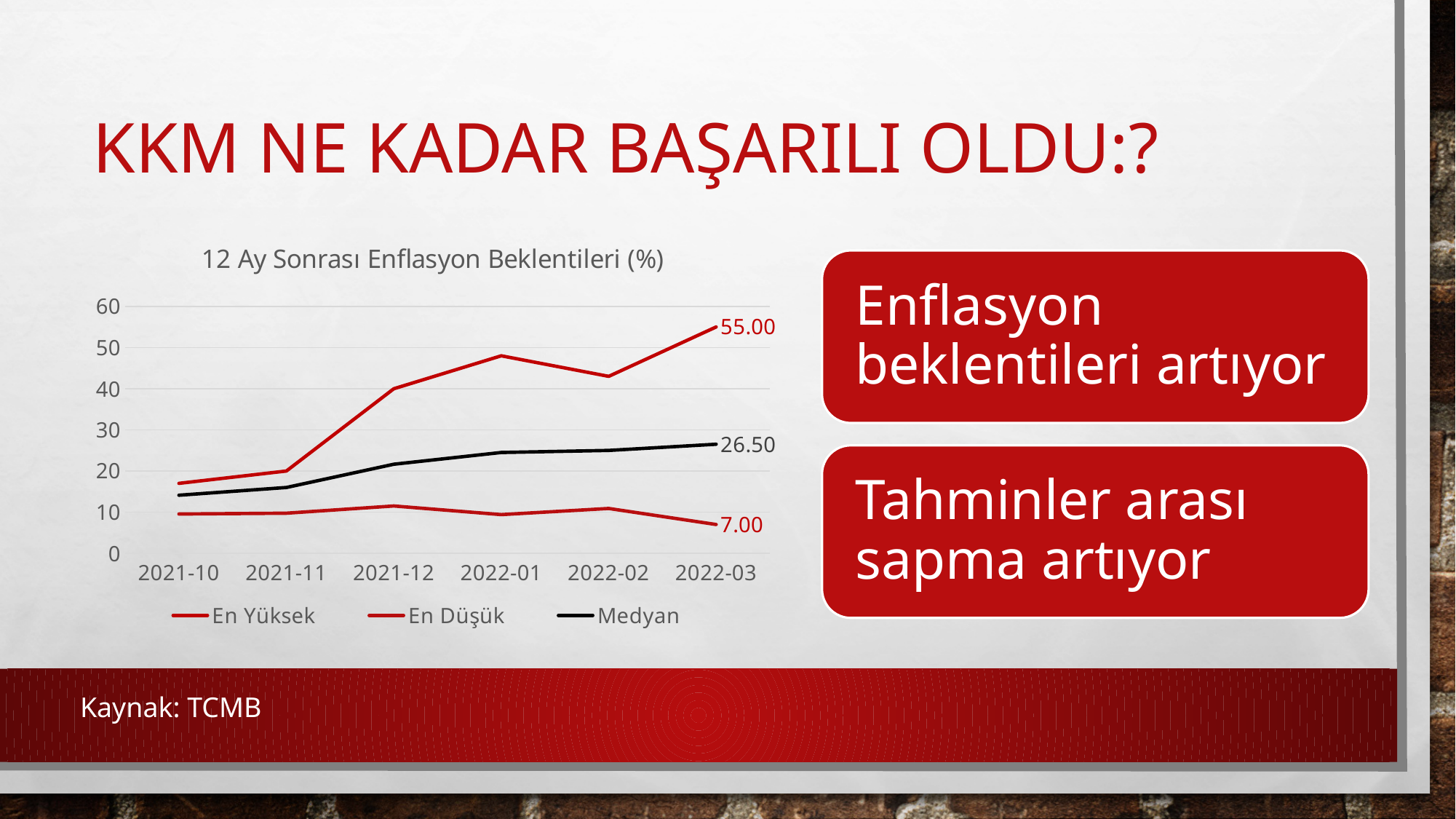
What kind of chart is shown on the slide? line chart How many series does the chart legend list? 3 Which series has the highest value at 2022-03? En Yüksek What is the value of the En Yüksek series at 2022-03? 55.00 What is the title of the chart? 12 Ay Sonrası Enflasyon Beklentileri (%) What is the value of the En Düşük series at 2022-03? 7.00 Is the value of the En Yüksek series at 2021-12 greater or less than 30? greater What is the difference between the En Yüksek and En Düşük values at 2022-03? 48.00 Does the Medyan series rise or fall from 2021-10 to 2022-03? rise Is the value of the Medyan series at 2021-10 greater or less than 20? less How many time points are plotted along the x axis of the chart? 6 What is the value of the Medyan series at 2022-03? 26.50